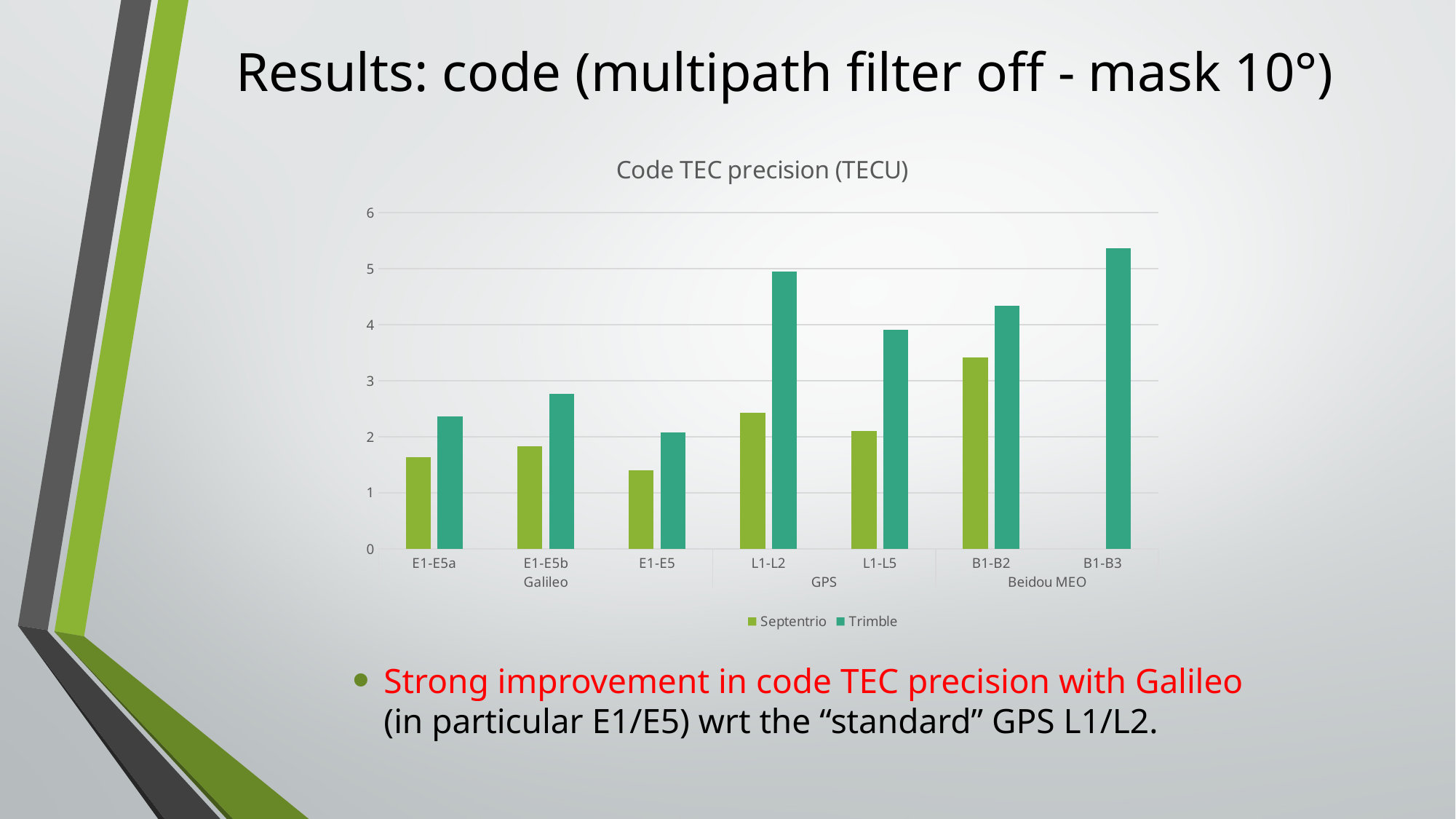
Is the Trimble value for B1-B3 greater or less than 5? greater Is the Septentrio value for E1-E5 greater or less than 2? less For E1-E5a, which series has the larger value, Septentrio or Trimble? Trimble What is the title of the chart? Code TEC precision (TECU) Is the Trimble value for L1-L2 greater or less than 4? greater Which category has the lowest Septentrio value? E1-E5 How many signal categories are shown along the x axis? 7 Which category has the highest Trimble value? B1-B3 What kind of chart is shown on the slide? bar chart Which category has the highest Septentrio value? B1-B2 How many series does the legend list? 2 Which is larger for Trimble: the value for L1-L2 or the value for L1-L5? L1-L2